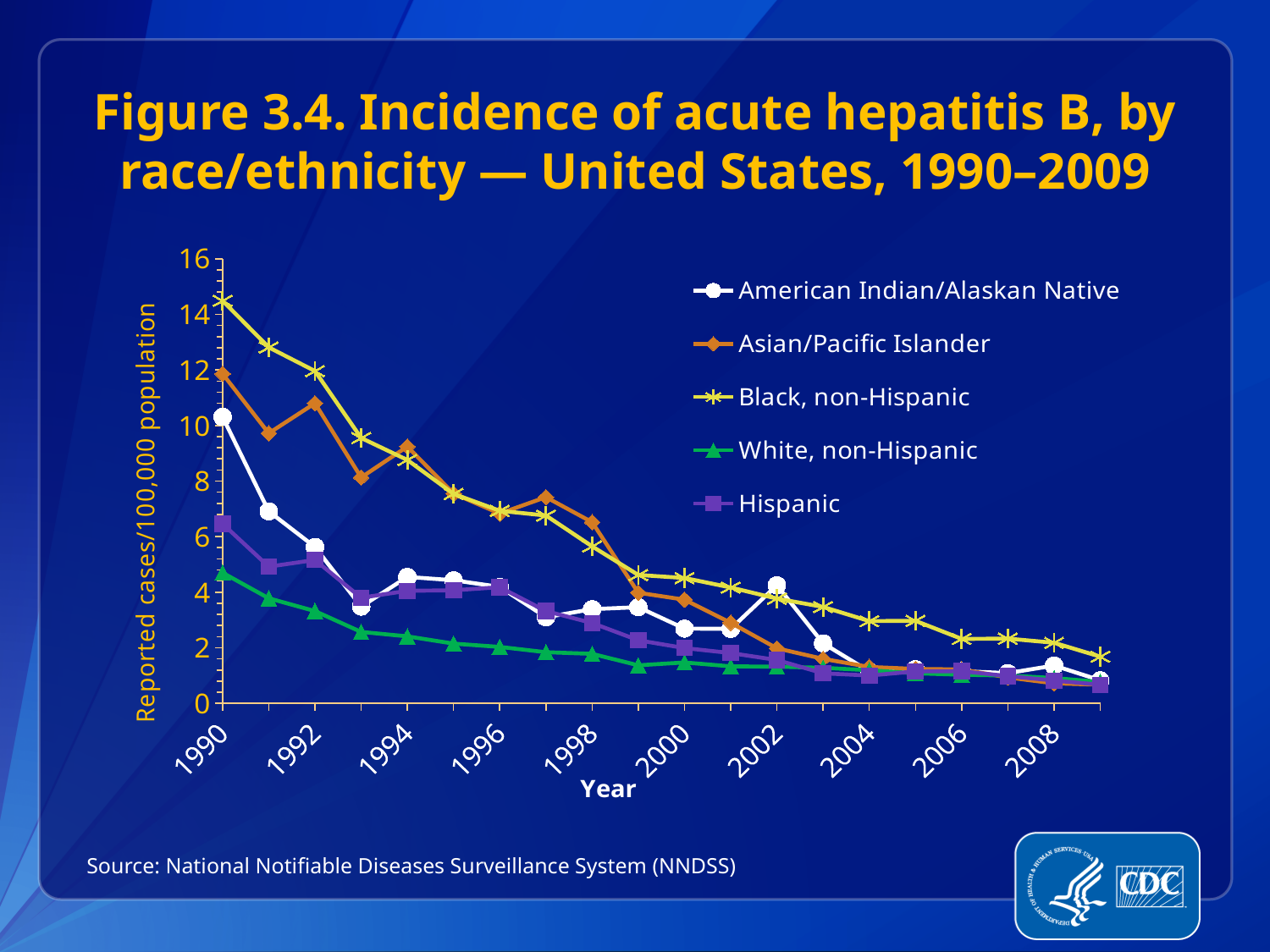
What is the label of the y axis? Reported cases/100,000 population Which race/ethnicity group has the lowest incidence in 1990? White, non-Hispanic Is the 1990 value for American Indian/Alaskan Native greater or less than 8? greater What kind of chart is shown on the slide? line chart In 1992, which is larger: the value for Black, non-Hispanic or for Hispanic? Black, non-Hispanic Does the incidence for Black, non-Hispanic rise or fall from 1990 to 2009? fall How many series does the legend list? 5 Is the 1990 value for Black, non-Hispanic greater or less than 12? greater Which race/ethnicity group has the highest incidence in 1990? Black, non-Hispanic In 1990, which is larger: the value for Asian/Pacific Islander or for American Indian/Alaskan Native? Asian/Pacific Islander How many years does the chart cover, from 1990 to 2009? 20 Is the 1990 value for White, non-Hispanic greater or less than 6? less